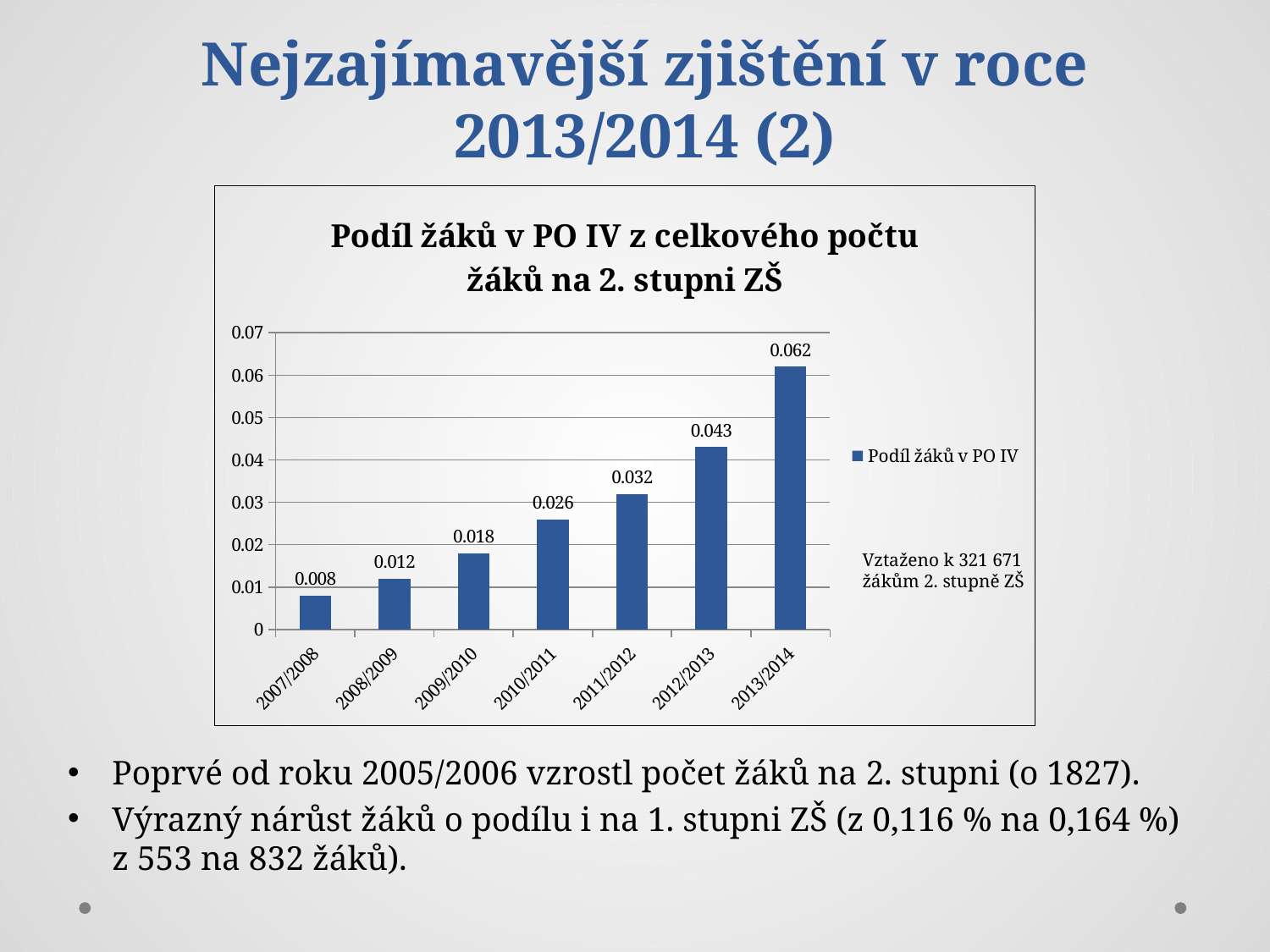
What is the value for 2011/2012? 0.032 Which school year has the highest value? 2013/2014 How many series does the legend list? 1 Which is larger, the value for 2008/2009 or the value for 2010/2011? 2010/2011 What is the difference between the values for 2013/2014 and 2012/2013? 0.019 How many school years are shown on the x axis? 7 What is the value for 2009/2010? 0.018 Which school year has the lowest value? 2007/2008 Do the values rise or fall from 2007/2008 to 2013/2014? rise What is the difference between the values for 2010/2011 and 2007/2008? 0.018 What kind of chart is shown? bar chart What is the value for 2013/2014? 0.062